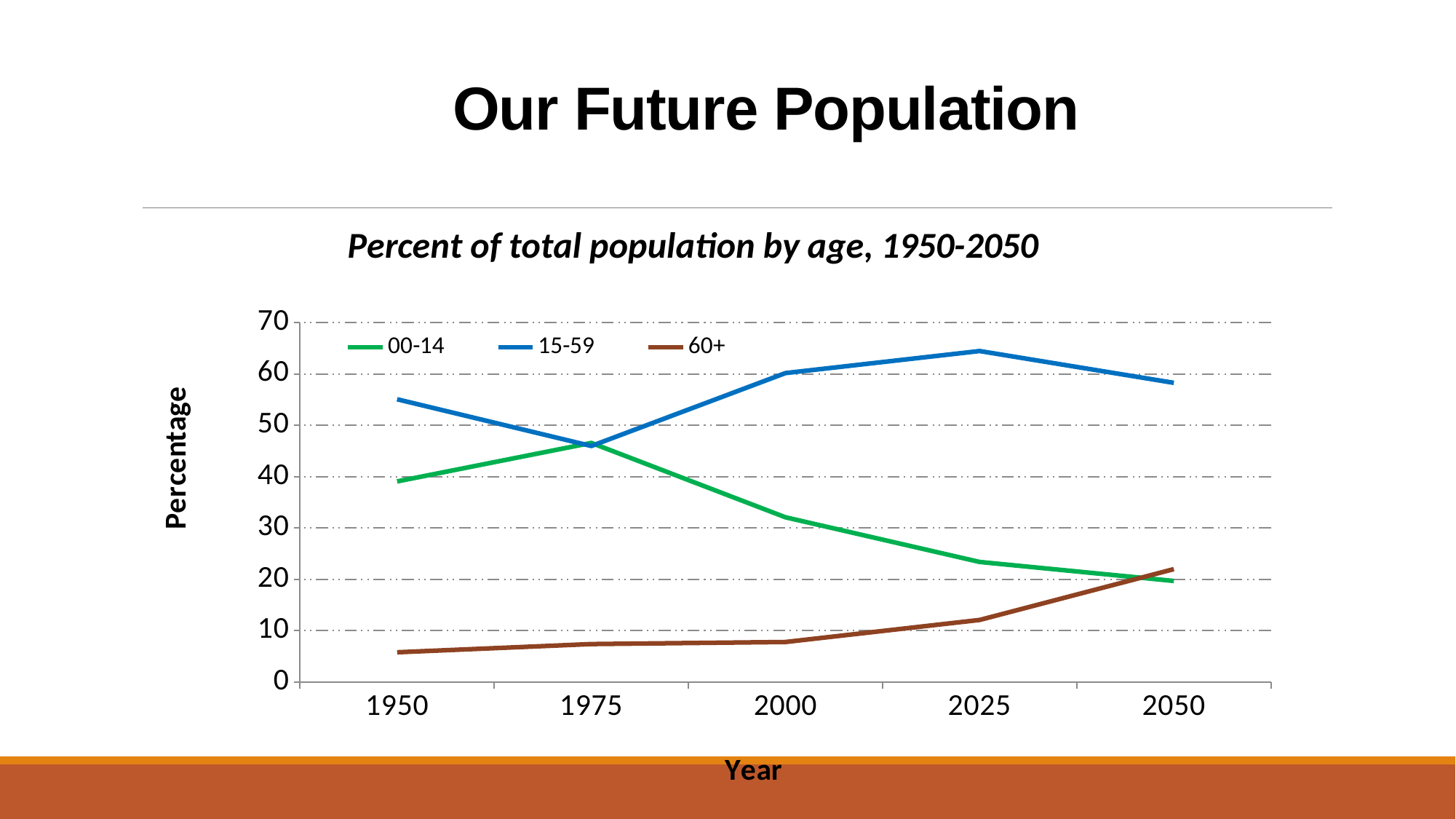
What kind of chart is shown on the slide? line chart Is the value for 60+ in 1950 greater or less than 10? less How many series does the legend list? 3 Is the value for 15-59 in 2025 greater or less than 60? greater Is the value for 15-59 in 1950 greater or less than 50? greater Does the 60+ series rise or fall from 1950 to 2050? rise In which year is the 60+ series at its highest? 2050 In which year does the 15-59 series reach its highest value? 2025 In which year is the 00-14 series at its lowest? 2050 What is the title of the chart? Percent of total population by age, 1950-2050 In 2000, which series has the larger value, 15-59 or 00-14? 15-59 How many years are plotted along the x axis? 5